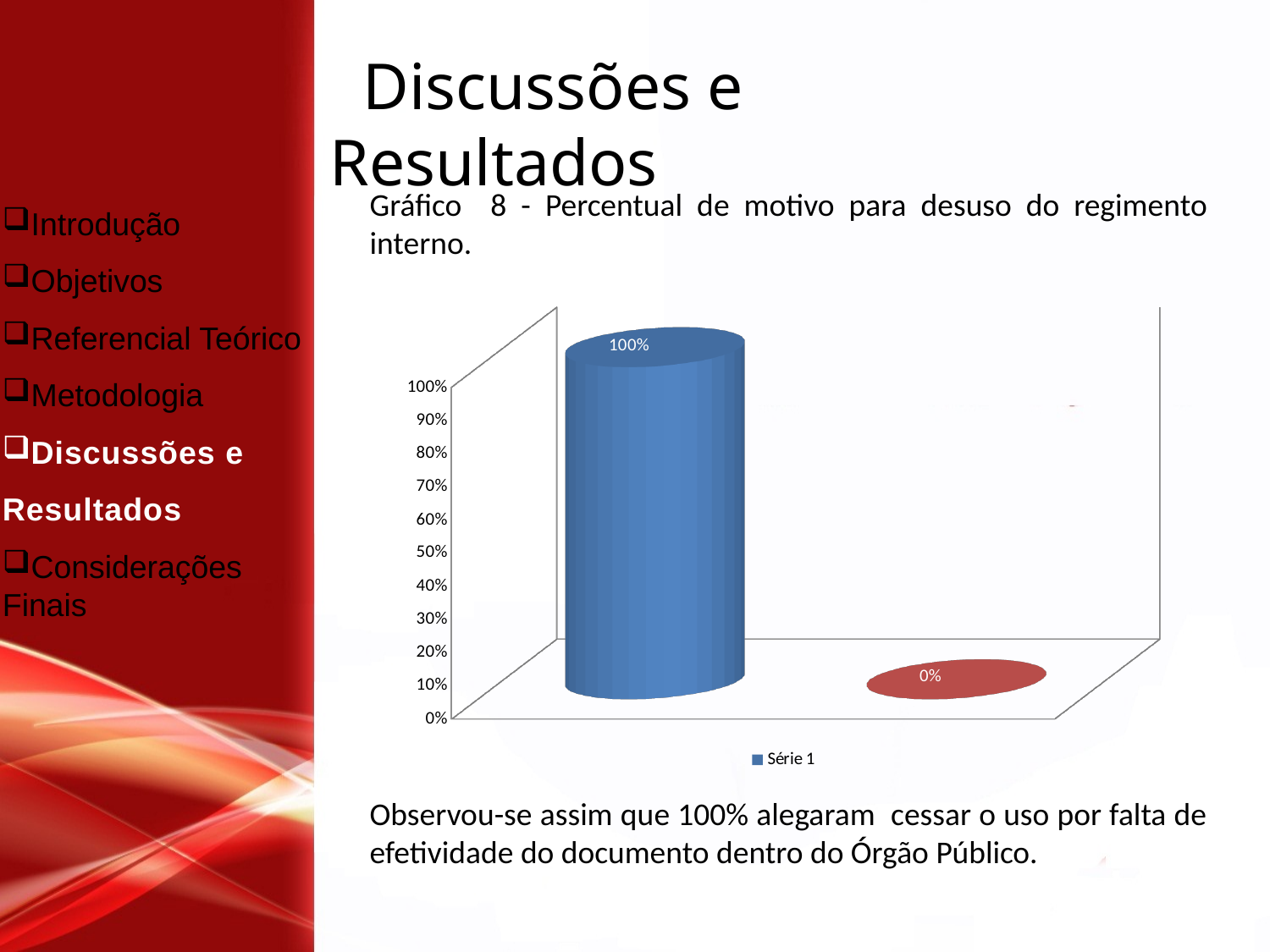
What is the difference between the left bar's value and the right bar's value? 100% What is the name of the series shown in the chart legend? Série 1 What is the lowest value shown in the chart? 0% What is the highest value shown in the chart? 100% What value is labelled on the right (red) bar of the chart? 0% How many bars are plotted in the chart? 2 What is the caption given for the chart on the slide? Gráfico 8 - Percentual de motivo para desuso do regimento interno. What kind of chart is shown on the slide? bar chart Is the value of the left blue bar greater or less than 50%? greater How many series does the chart legend list? 1 Which bar is larger, the left blue bar or the right red bar? the left blue bar What value is labelled on the left (blue) bar of the chart? 100%